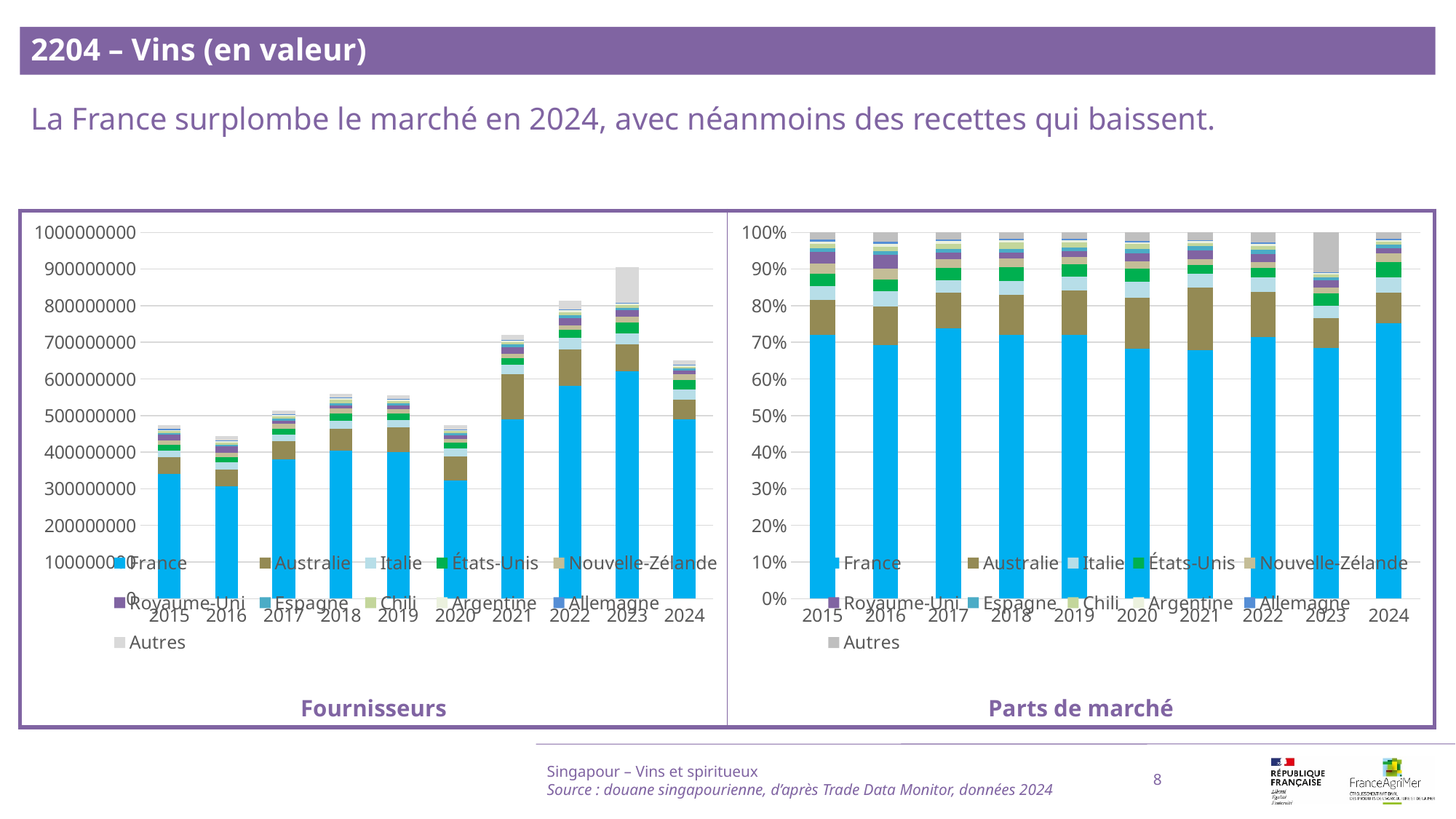
In the "Fournisseurs" chart, which year has the larger total bar, 2021 or 2022? 2022 Which series is shown in light blue at the bottom of each bar in both charts? France What kind of chart is the "Fournisseurs" chart on the left? stacked bar chart In the "Fournisseurs" chart, is the France segment for 2023 greater or less than 500000000? greater In the "Fournisseurs" chart, which year has the tallest stacked bar? 2023 In the "Parts de marché" chart, is the France share for 2024 greater or less than 70%? greater In the "Fournisseurs" chart, which year has the shortest stacked bar? 2016 How many years are shown on the x axis of the "Parts de marché" chart? 10 In the "Fournisseurs" chart, is the total stacked bar for 2016 greater or less than 500000000? less In the "Fournisseurs" chart, does the total bar rise or fall from 2023 to 2024? fall How many series does the legend of the "Fournisseurs" chart list? 11